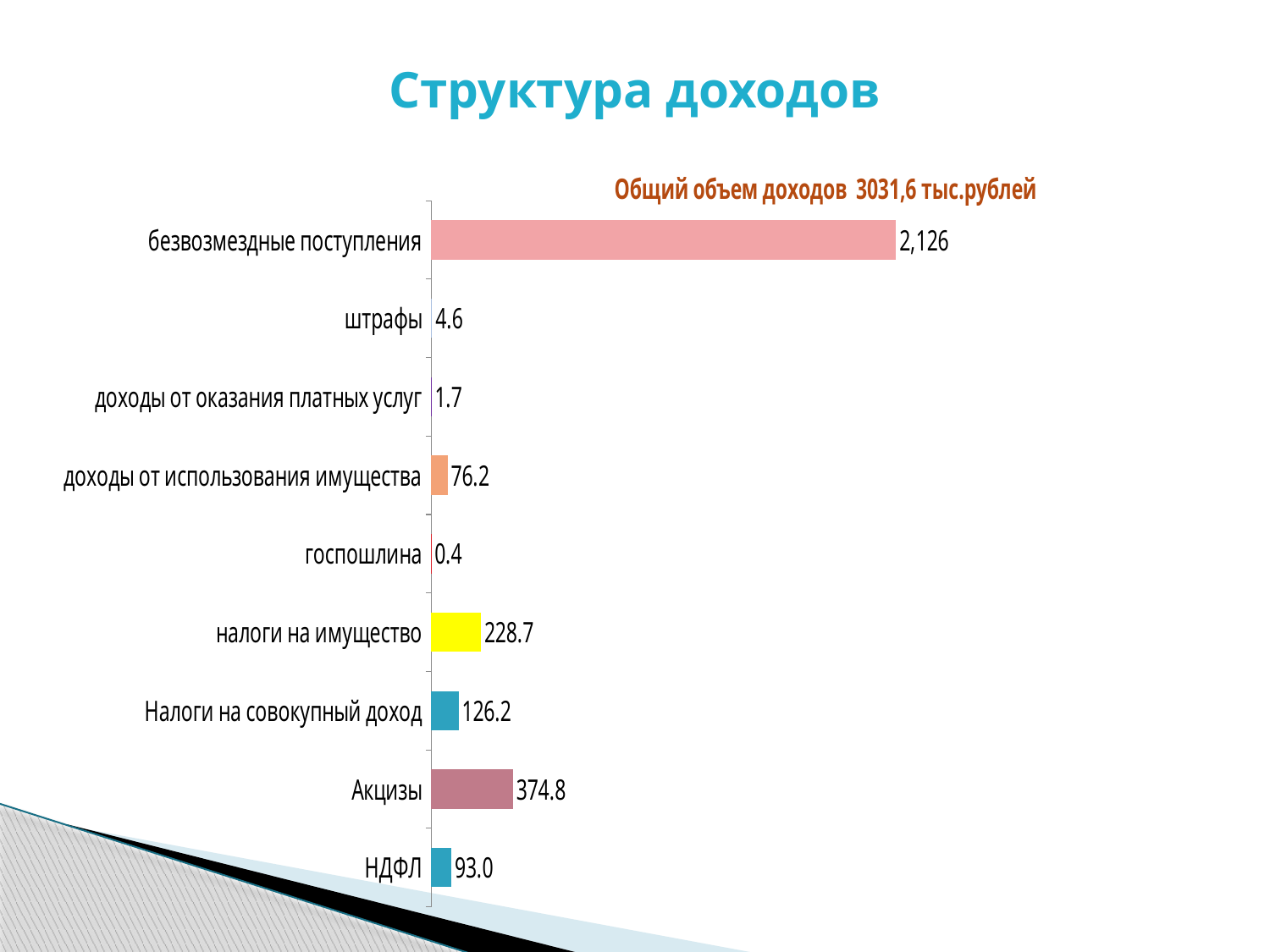
Which category has the highest value? безвозмездные поступления What is the value for госпошлина? 0.4 How many categories are shown in the chart? 9 Which category has the lowest value? госпошлина What is the difference between Акцизы and налоги на имущество? 146.1 What total income volume is stated above the chart? 3031,6 тыс.рублей What is the value for Акцизы? 374.8 What is the value for НДФЛ? 93.0 What is the value for налоги на имущество? 228.7 What is the value for безвозмездные поступления? 2,126 What kind of chart is shown on the slide? bar chart Which is larger, Налоги на совокупный доход or НДФЛ? Налоги на совокупный доход